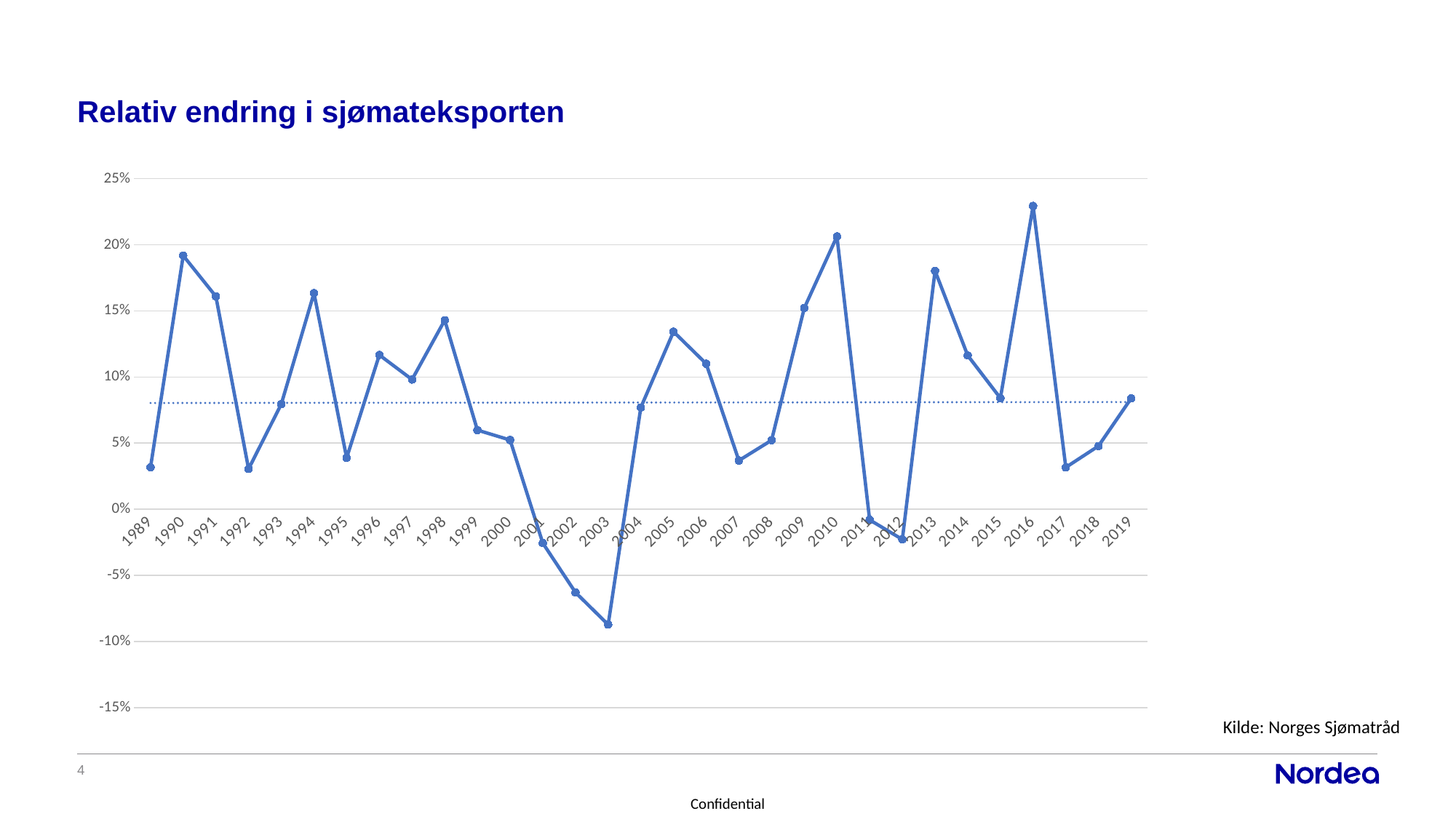
Which year has the lowest value? 2003 Is the value for 2016 greater or less than 20%? greater Which year has the larger value, 2002 or 2003? 2002 What is the title of the chart? Relativ endring i sjømateksporten Is the value for 2001 greater or less than 0%? less Which year has the larger value, 1990 or 1991? 1990 Do the values rise or fall from 2001 to 2003? fall Is the value for 2003 greater or less than -5%? less What kind of chart is shown on the slide? line chart Which year has the highest value? 2016 How many years are plotted on the x axis? 31